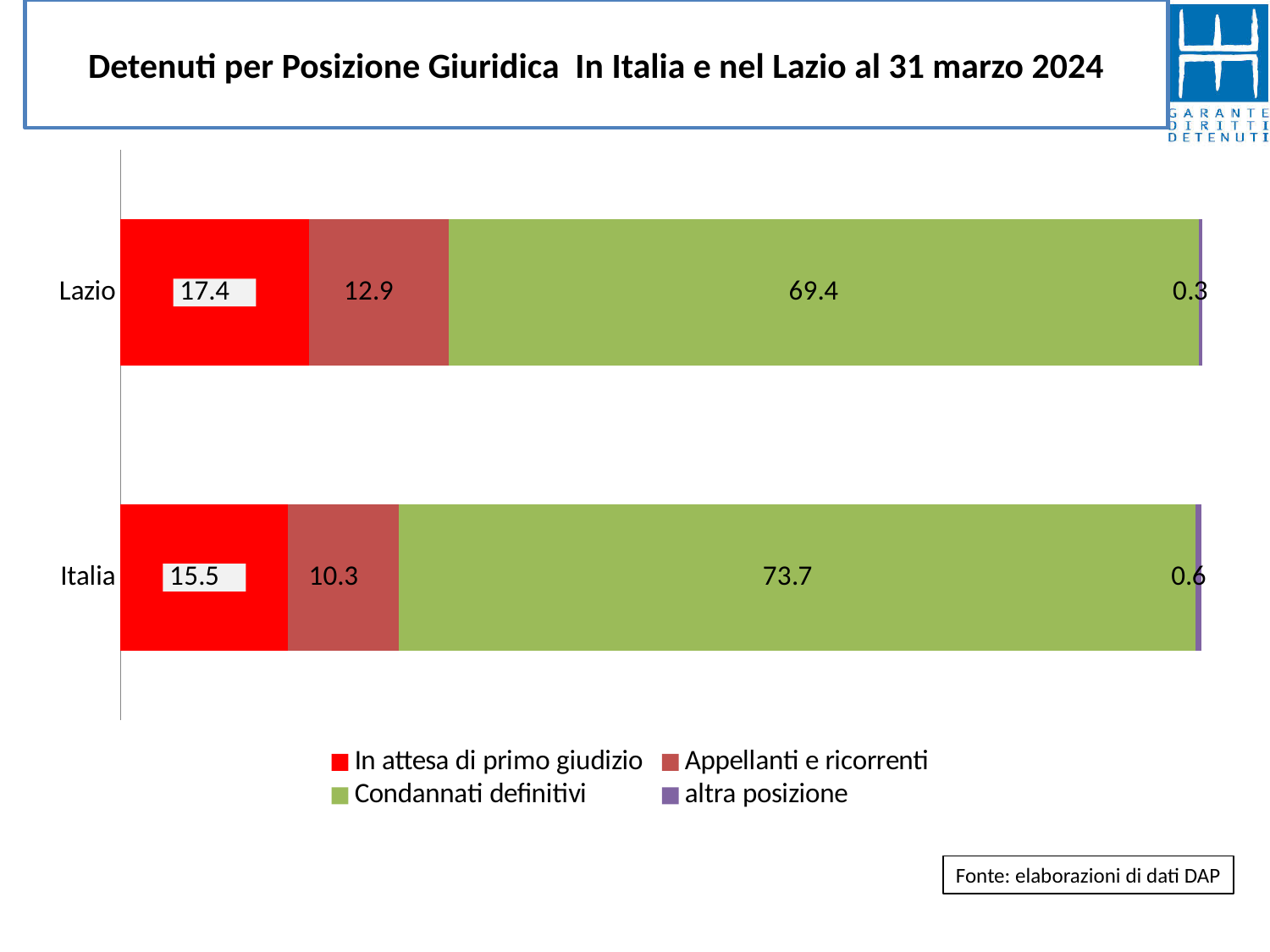
What is the total of the stacked bar for Lazio? 100 How many series does the legend list? 4 What is the difference between the Condannati definitivi values for Italia and Lazio? 4.3 What is the value for altra posizione for Italia? 0.6 What is the value for In attesa di primo giudizio for Lazio? 17.4 What is the value for Condannati definitivi for Italia? 73.7 What kind of chart is shown on the slide? Stacked bar chart Which series has the smallest value for Lazio? altra posizione Which series has the largest value for Italia? Condannati definitivi What is the value for Appellanti e ricorrenti for Lazio? 12.9 Which has a larger value for In attesa di primo giudizio, Lazio or Italia? Lazio How many categories are shown on the y axis? 2